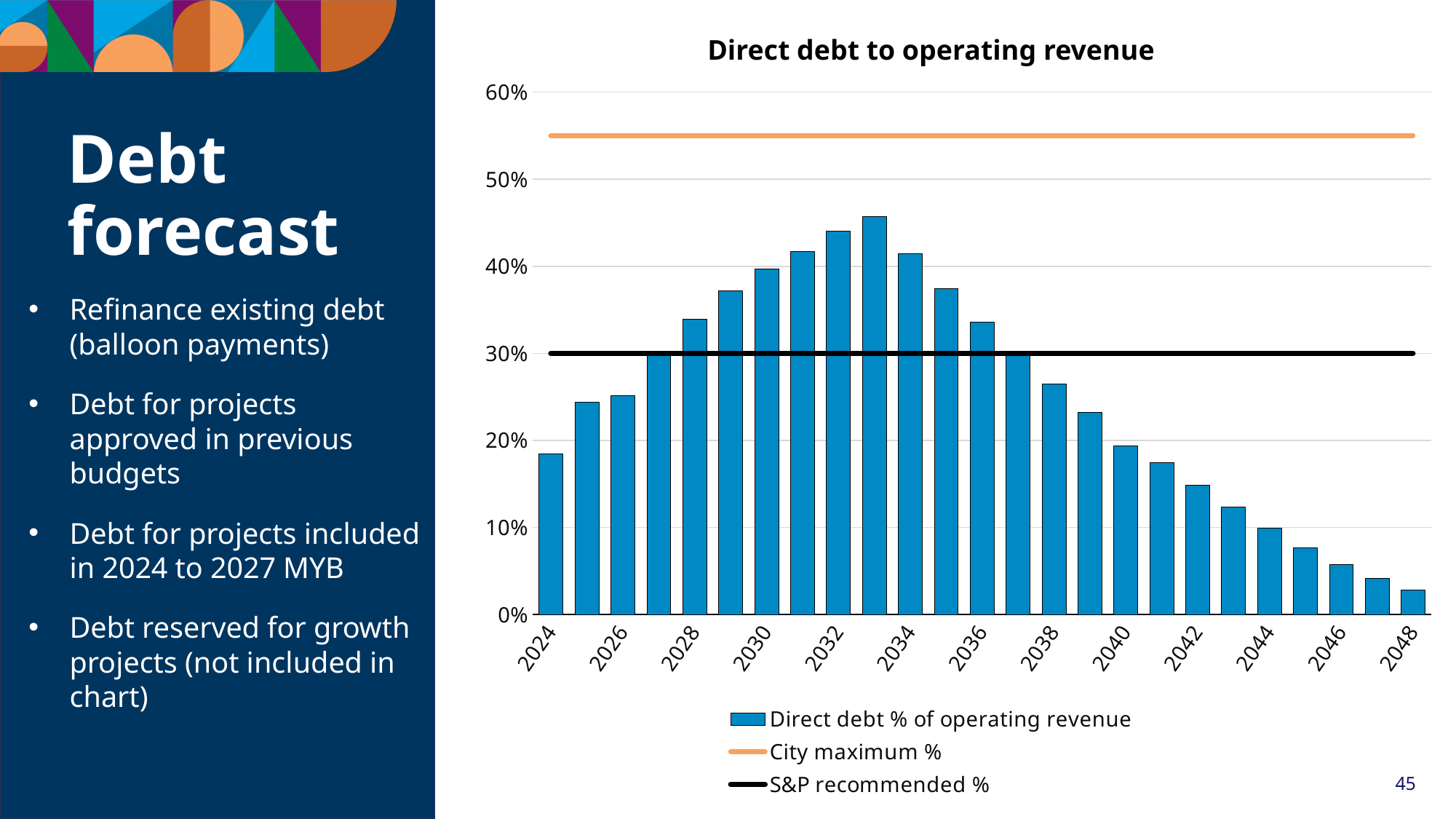
What is the title of the chart? Direct debt to operating revenue What value does the S&P recommended % line sit at? 30% Which year has the lowest direct debt % of operating revenue? 2048 Is the direct debt % of operating revenue for 2030 greater or less than 30%? greater Do the direct debt % of operating revenue values rise or fall from 2033 to 2048? fall How many entries does the chart's legend list? 3 How many years (bars) are plotted on the chart? 25 Which year has the highest direct debt % of operating revenue? 2033 Is the direct debt % of operating revenue for 2024 greater or less than 20%? less Which year has a larger direct debt % of operating revenue, 2030 or 2040? 2030 Is the direct debt % of operating revenue for 2046 greater or less than 10%? less What kind of chart is shown on the slide? Bar chart